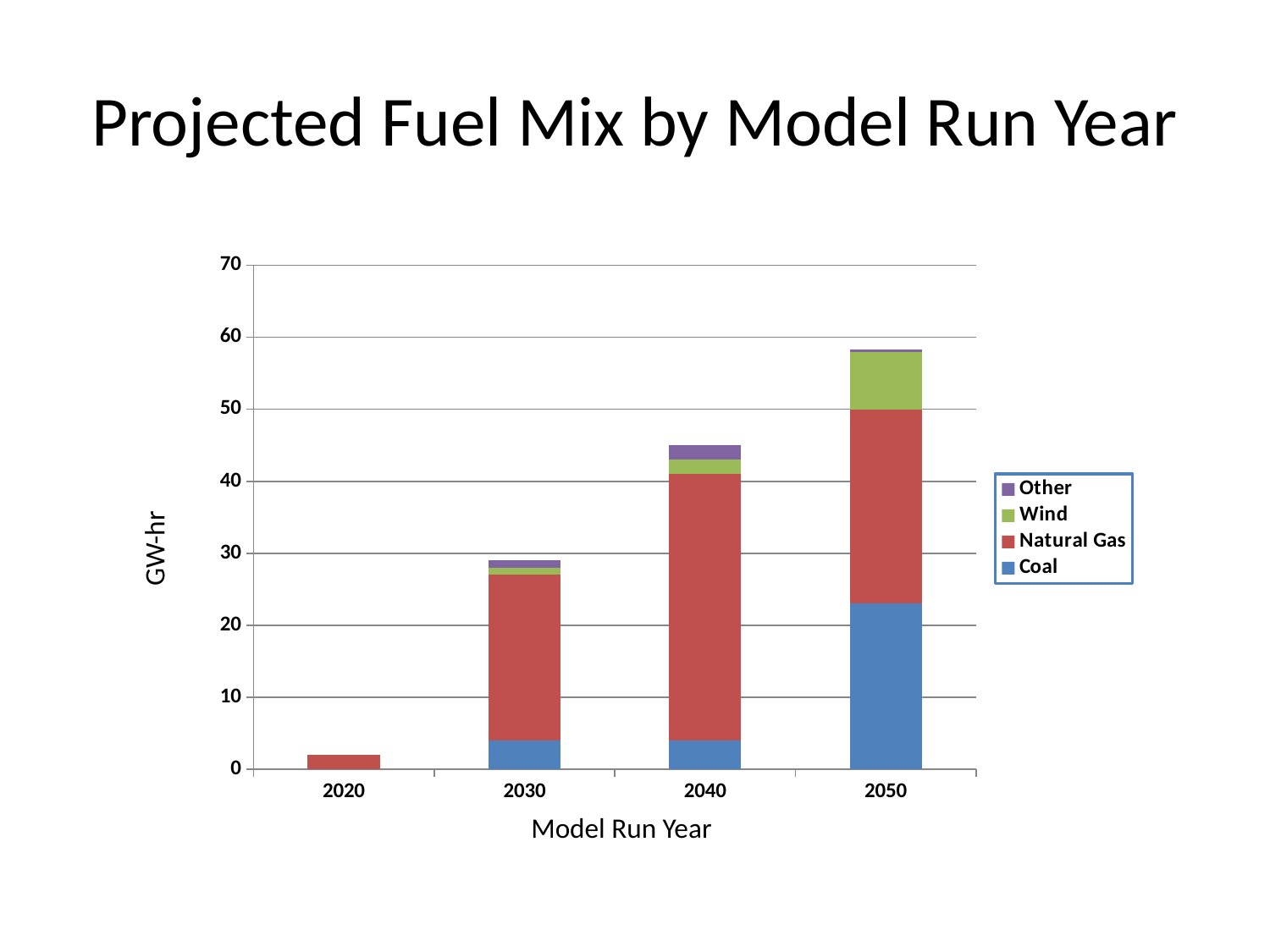
Is the Coal value for 2050 greater or less than 20? greater Is the total for 2030 greater or less than 30? less Which year has the larger Coal segment, 2040 or 2050? 2050 What kind of chart is shown on the slide? stacked bar chart Which model run year has the tallest stacked bar? 2050 How many series does the legend list? 4 Is the total for 2040 greater or less than 40? greater Do the total bar heights rise or fall from 2020 to 2050? rise Which model run year has the shortest stacked bar? 2020 What is the label on the vertical axis? GW-hr How many model run years are shown on the x axis? 4